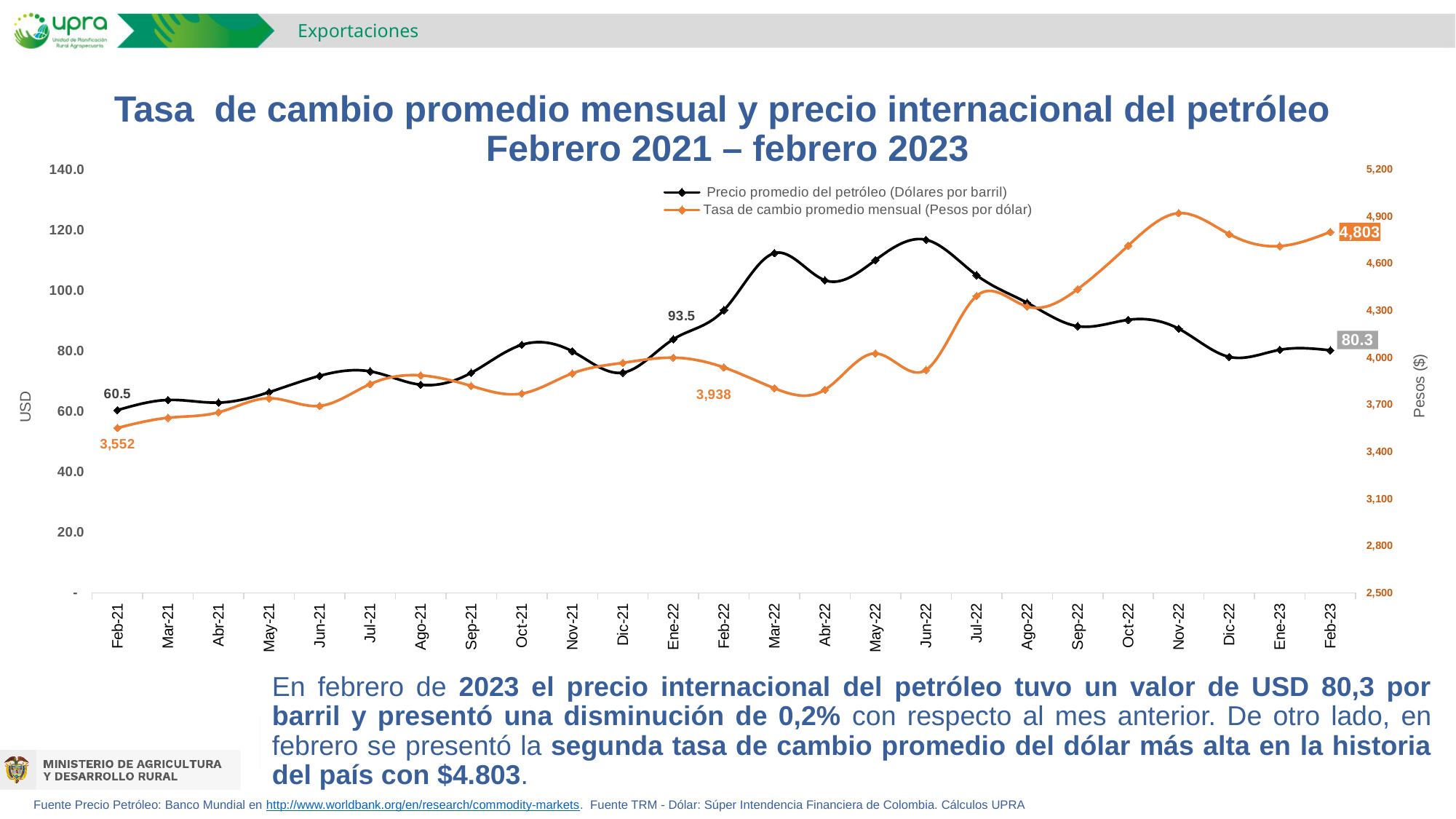
Which is larger, the Precio promedio del petróleo in Ene-22 or in Feb-23? Ene-22 In which month is the Tasa de cambio promedio mensual at its lowest? Feb-21 What kind of chart is shown on the slide? Line chart What is the difference between the Tasa de cambio promedio mensual in Feb-23 and in Feb-21? 1,251 How many series does the legend list? 2 Is the value of Precio promedio del petróleo for Jun-22 greater or less than 100.0? greater What is the value of Tasa de cambio promedio mensual for Feb-23? 4,803 In which month does the Tasa de cambio promedio mensual reach its highest value? Nov-22 What is the value of Precio promedio del petróleo for Feb-21? 60.5